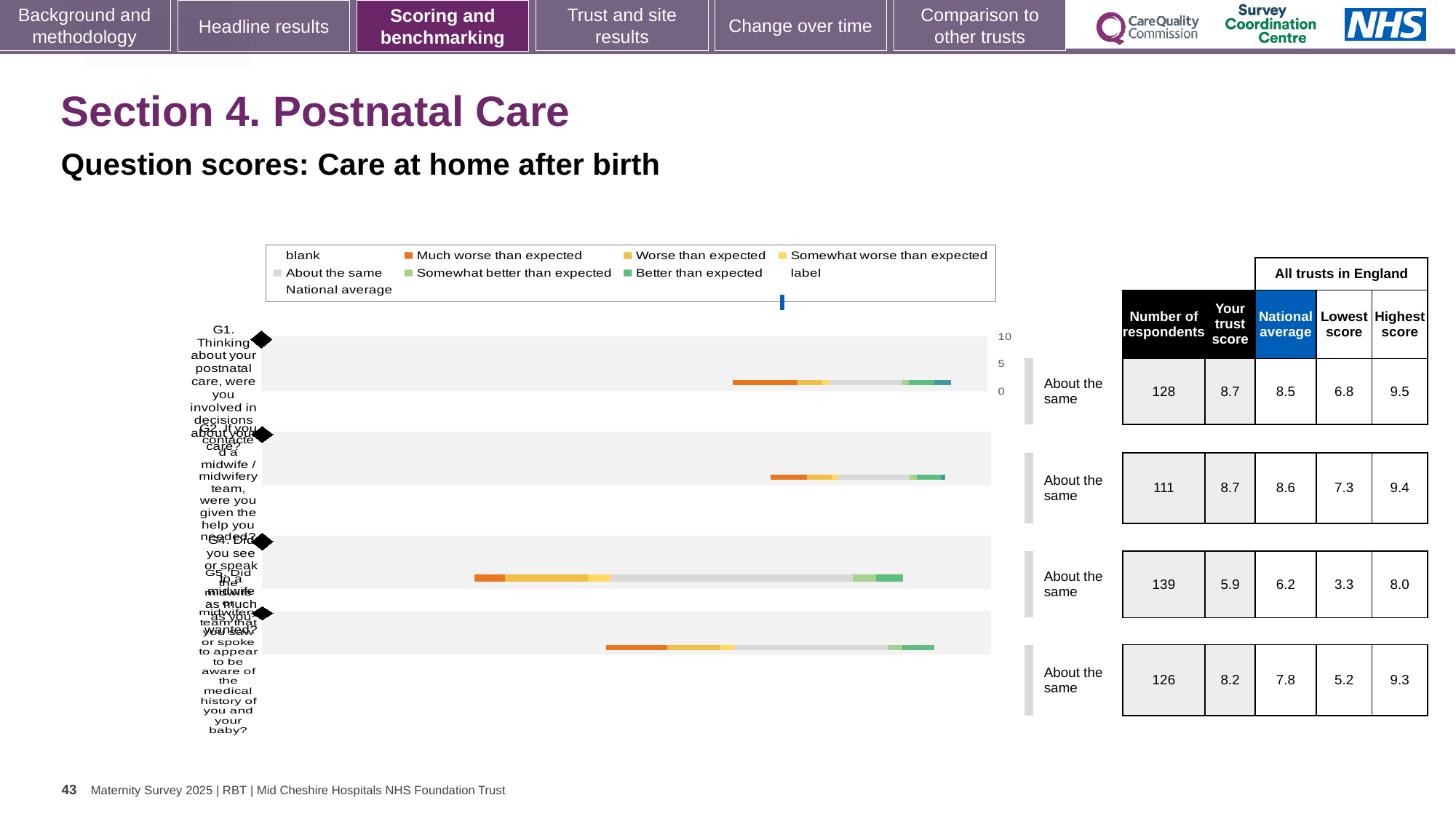
Which question row has the lowest 'Your trust score' in the table beside the chart? G4 In the table beside the chart, what is the difference between the Highest score and the Lowest score for the first row (G1)? 2.7 For the fourth row (G5), which is larger: the 'Your trust score' or the National average? Your trust score In the table beside the chart, what is the 'Your trust score' for the first row (G1)? 8.7 How many question bars (G1, G2, G4, G5) are plotted in the chart? 4 What is the first entry listed in the chart legend? blank In the table beside the chart, how many respondents are listed for the third row (G4)? 139 What kind of chart is shown on the slide? bar chart What benchmark text is shown beside each bar in the chart? About the same In the table beside the chart, what is the National average for the second row (G2)? 8.6 How many entries does the chart legend list? 9 In the table beside the chart, what is the Lowest score for the third row (G4)? 3.3